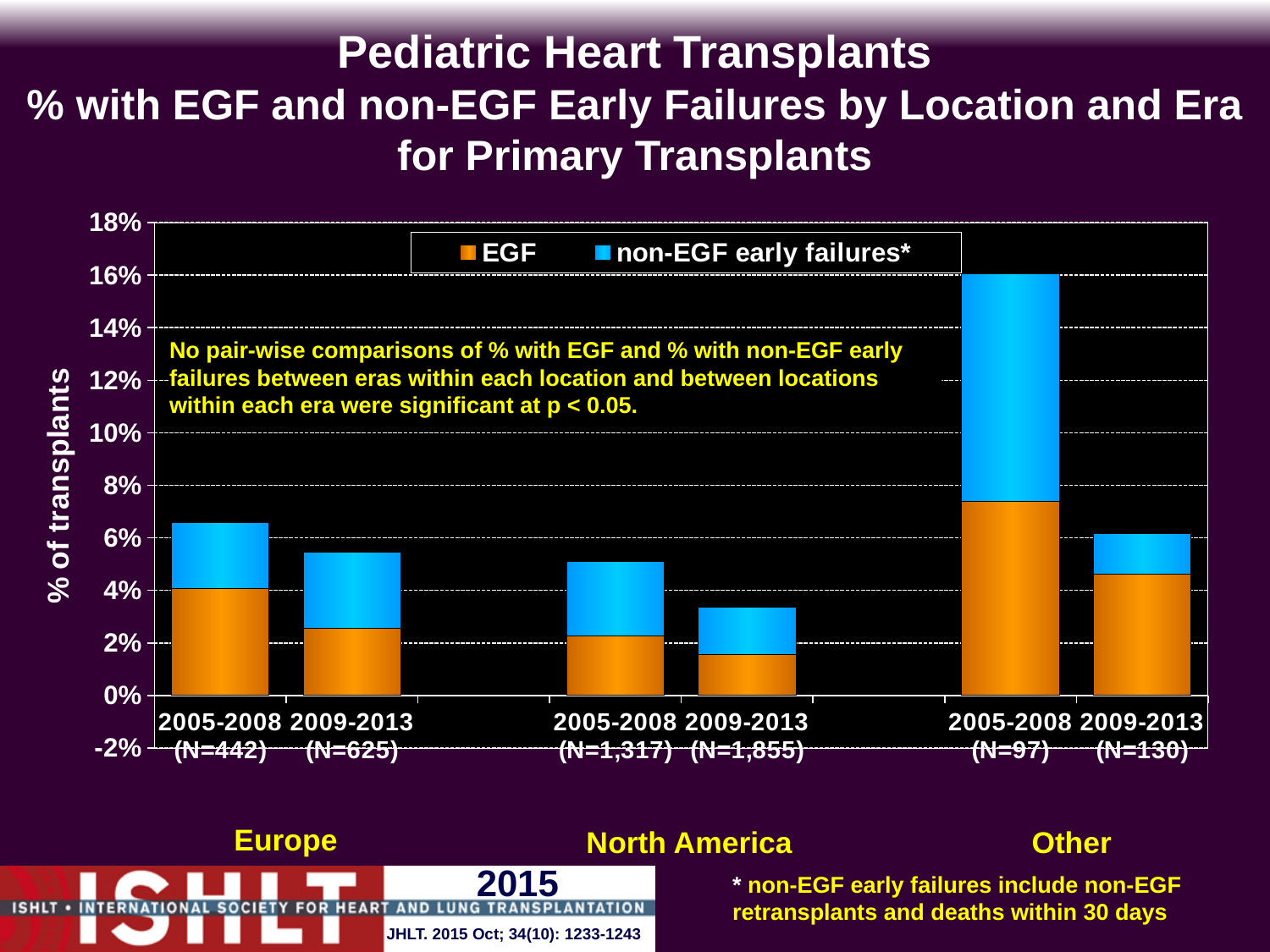
How many series does the legend list? 2 Is the total value for Other 2005-2008 (N=97) greater or less than 14%? greater Which bar has the highest total % of transplants? Other, 2005-2008 (N=97) Is the total value for North America 2009-2013 (N=1,855) greater or less than 4%? less Which has the larger total: Europe 2005-2008 (N=442) or Europe 2009-2013 (N=625)? Europe 2005-2008 (N=442) Is the EGF portion for Other 2005-2008 (N=97) greater or less than 6%? greater What kind of chart is shown on the slide? Stacked bar chart Which bar has the lowest total % of transplants? North America, 2009-2013 (N=1,855) Within each location, does the total % of transplants rise or fall from the 2005-2008 era to the 2009-2013 era? Fall What are the two series named in the legend? EGF and non-EGF early failures* Which three locations are shown along the x axis? Europe, North America, Other How many bars are plotted in the chart? 6